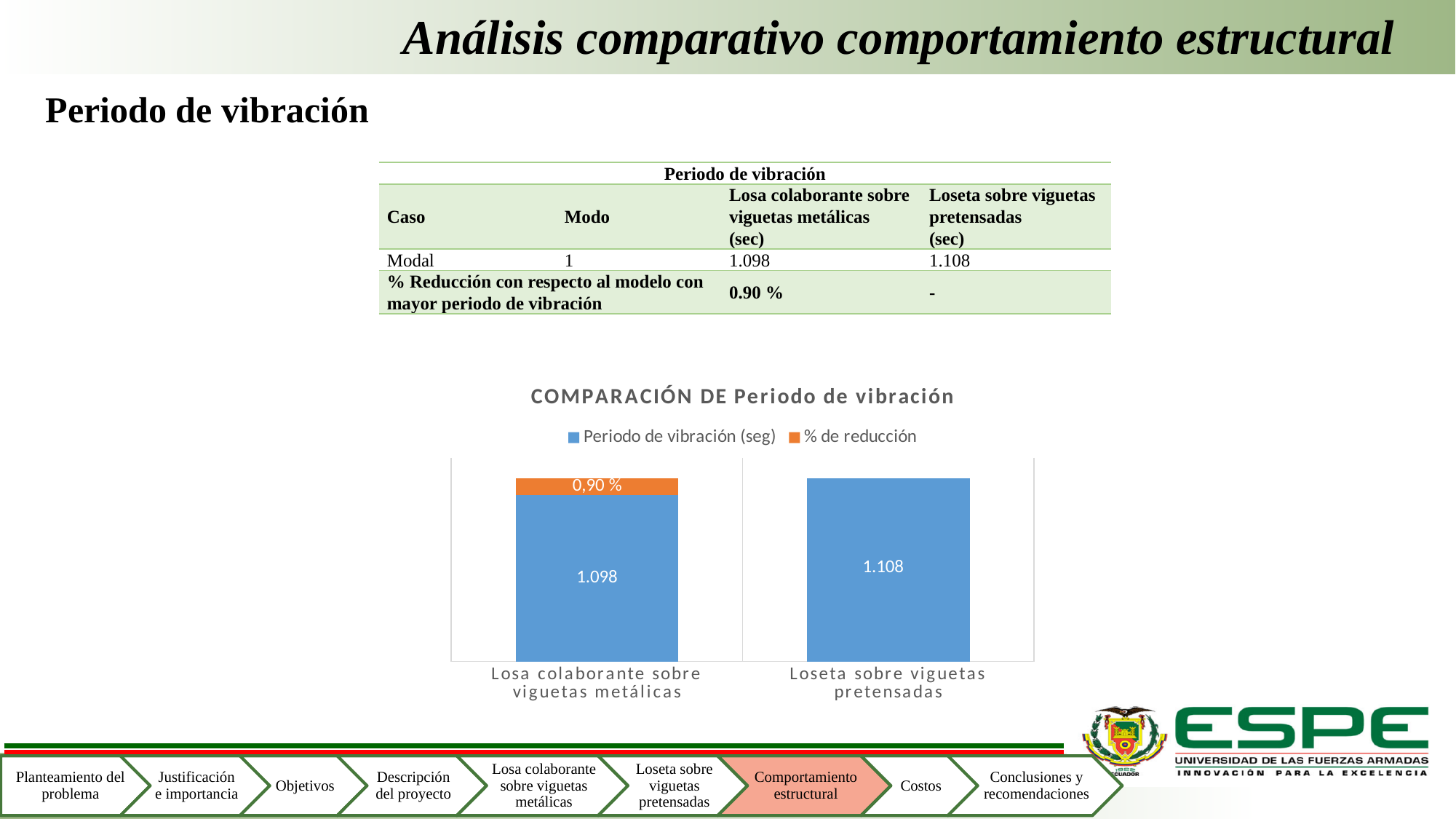
What is the Periodo de vibración (seg) value for Loseta sobre viguetas pretensadas? 1.108 Is the Periodo de vibración (seg) larger for Losa colaborante sobre viguetas metálicas or for Loseta sobre viguetas pretensadas? Loseta sobre viguetas pretensadas What is the Periodo de vibración (seg) value for Losa colaborante sobre viguetas metálicas? 1.098 Which series is shown in orange in the chart? % de reducción Which category has the higher Periodo de vibración (seg)? Loseta sobre viguetas pretensadas What kind of chart is shown on the slide? Bar chart What is the difference in Periodo de vibración (seg) between Loseta sobre viguetas pretensadas and Losa colaborante sobre viguetas metálicas? 0.010 How many series does the chart legend list? 2 What is the title of the chart? COMPARACIÓN DE Periodo de vibración How many categories are shown on the x axis of the chart? 2 Which category has the lower Periodo de vibración (seg)? Losa colaborante sobre viguetas metálicas What is the % de reducción value shown for Losa colaborante sobre viguetas metálicas? 0,90 %